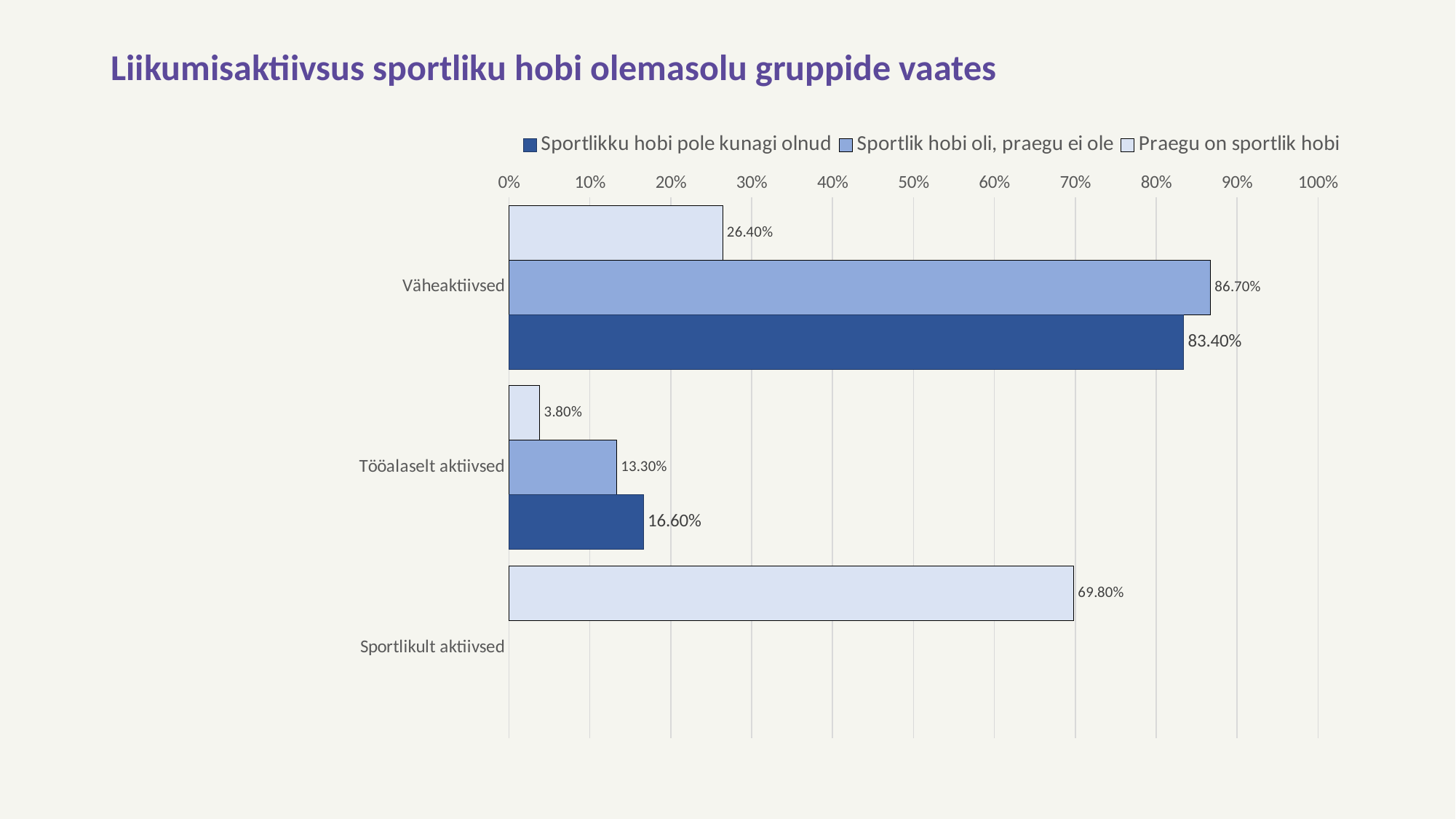
How many series does the legend list? 3 Which series has the lowest value in the Tööalaselt aktiivsed category? Praegu on sportlik hobi What kind of chart is shown on the slide? bar chart How many categories are shown on the vertical axis? 3 Which is larger in the Tööalaselt aktiivsed category: 'Sportlik hobi oli, praegu ei ole' or 'Sportlikku hobi pole kunagi olnud'? Sportlikku hobi pole kunagi olnud What is the value for 'Sportlik hobi oli, praegu ei ole' in the Väheaktiivsed category? 86.70% Is the value for 'Praegu on sportlik hobi' in the Väheaktiivsed category greater or less than 30%? less What is the difference between 'Sportlik hobi oli, praegu ei ole' and 'Sportlikku hobi pole kunagi olnud' in the Väheaktiivsed category? 3.30% Which series has the highest value in the Väheaktiivsed category? Sportlik hobi oli, praegu ei ole What is the value for 'Sportlikku hobi pole kunagi olnud' in the Tööalaselt aktiivsed category? 16.60% What is the title of the chart? Liikumisaktiivsus sportliku hobi olemasolu gruppide vaates What is the value for 'Praegu on sportlik hobi' in the Sportlikult aktiivsed category? 69.80%